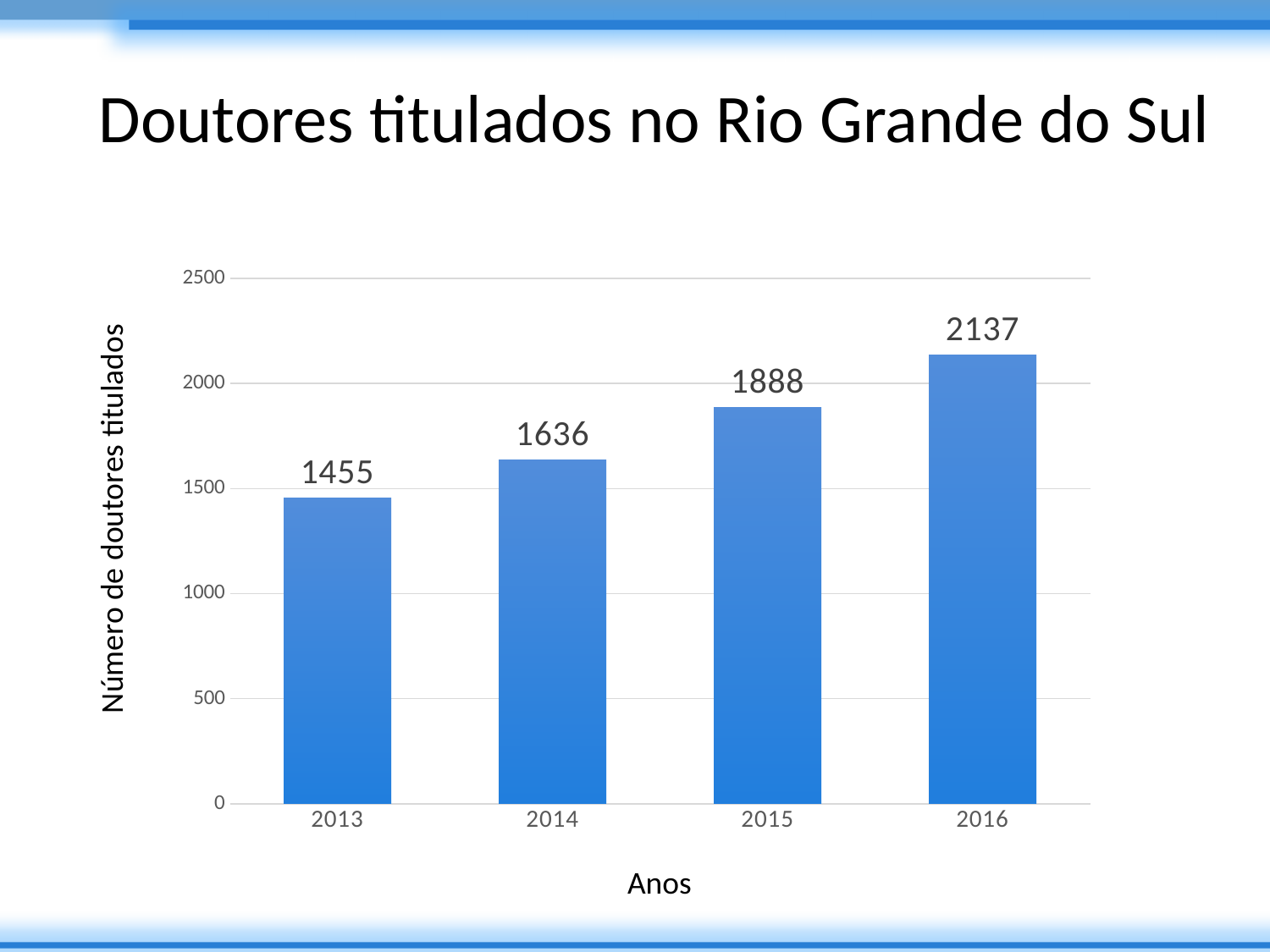
What is the number of doutores titulados in 2016? 2137 Is the value for 2016 greater or less than 2000? greater What is the difference between the values for 2015 and 2014? 252 Which year has the highest number of doutores titulados? 2016 What is the value shown for 2015? 1888 What kind of chart is shown on the slide? bar chart How many years are shown on the x axis? 4 Do the values rise or fall from 2013 to 2016? rise What is the number of doutores titulados in 2013? 1455 Which year has the lowest number of doutores titulados? 2013 What is the difference between the values for 2016 and 2013? 682 Which is larger, the value for 2014 or the value for 2015? 2015